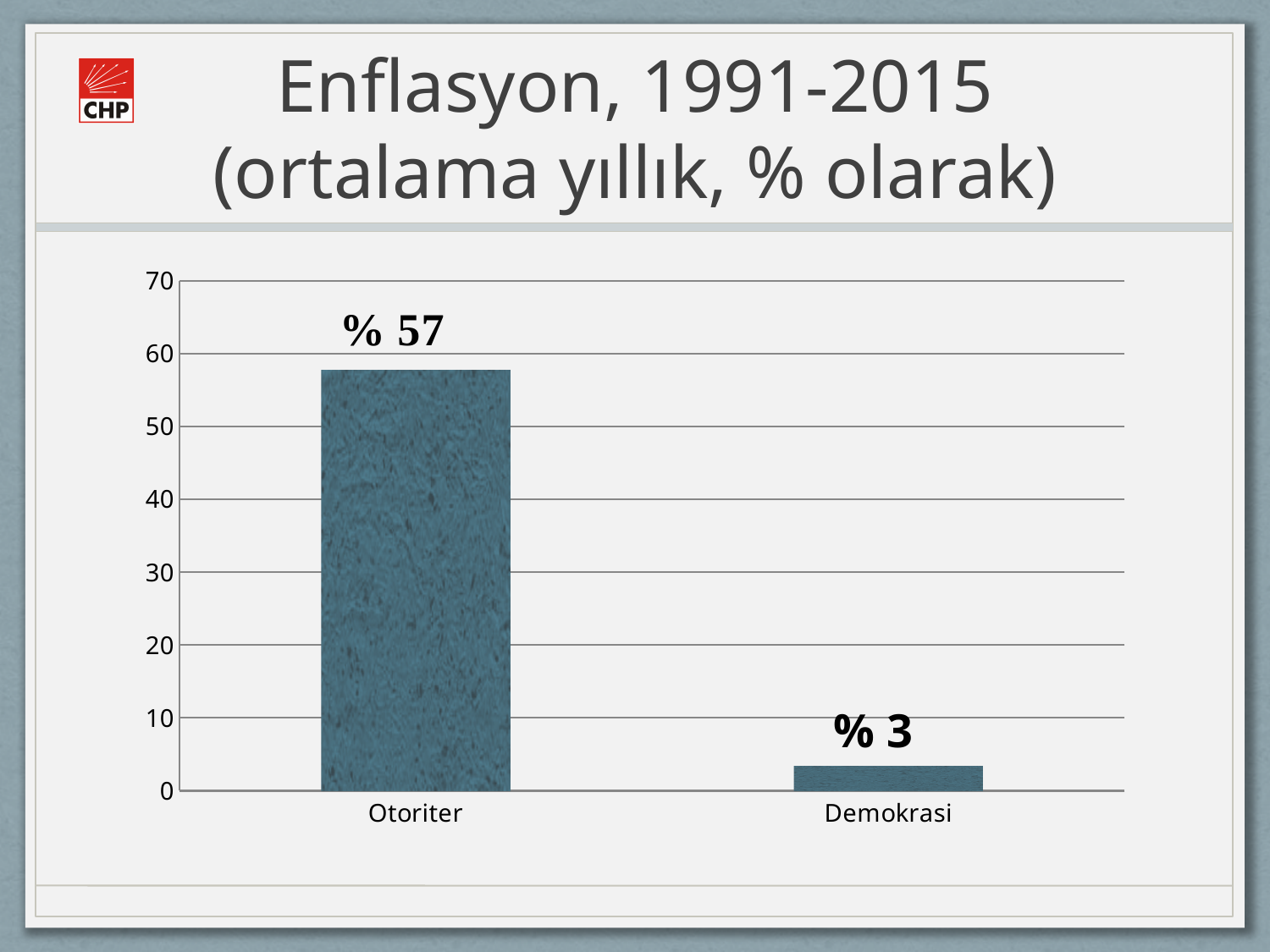
Which category has the highest value? Otoriter What is the highest value shown on the y axis? 70 What is the difference between the values for Otoriter and Demokrasi? 54 Is the value for Otoriter greater or less than 50? greater What is the value shown for Demokrasi? % 3 What is the title of the slide? Enflasyon, 1991-2015 (ortalama yıllık, % olarak) Which is larger, the value for Otoriter or the value for Demokrasi? Otoriter Is the value for Demokrasi greater or less than 10? less What is the value shown for Otoriter? % 57 What kind of chart is shown on the slide? bar chart Which category has the lowest value? Demokrasi How many categories are shown on the x axis? 2